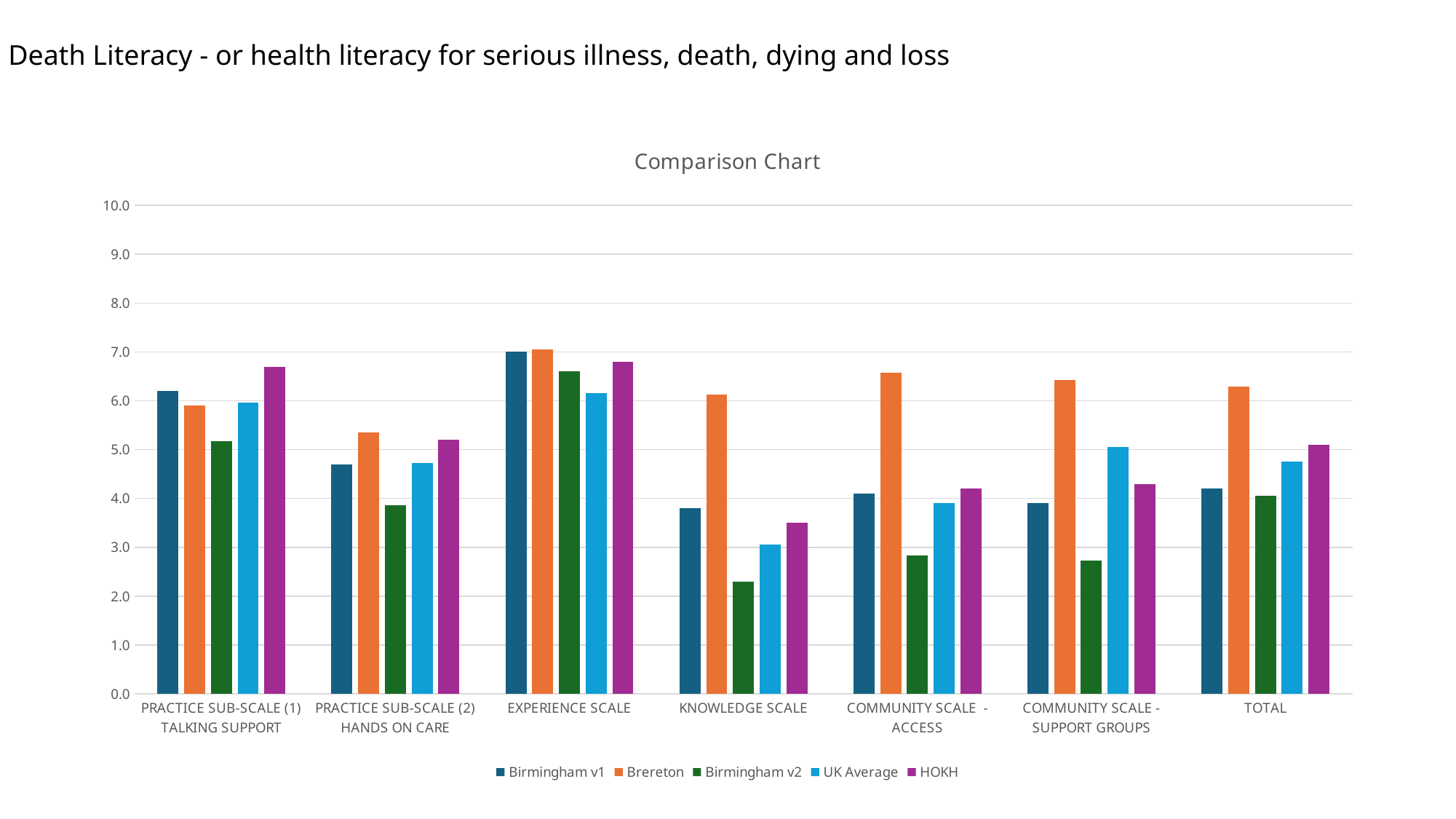
Is the Brereton value for TOTAL greater or less than 6.0? greater Which series has the lowest value for KNOWLEDGE SCALE? Birmingham v2 Is the Birmingham v2 value for COMMUNITY SCALE - SUPPORT GROUPS greater or less than 3.0? less What is the title of the chart on the slide? Comparison Chart Which series has the lowest value for EXPERIENCE SCALE? UK Average Which series has the highest value for PRACTICE SUB-SCALE (1) TALKING SUPPORT? HOKH What kind of chart is the Comparison Chart? bar chart For COMMUNITY SCALE - SUPPORT GROUPS, which is larger: the UK Average value or the Birmingham v1 value? UK Average Which series has the highest value for KNOWLEDGE SCALE? Brereton How many categories are shown on the x axis of the Comparison Chart? 7 How many series does the legend of the Comparison Chart list? 5 For COMMUNITY SCALE - ACCESS, which is larger: the Brereton value or the HOKH value? Brereton